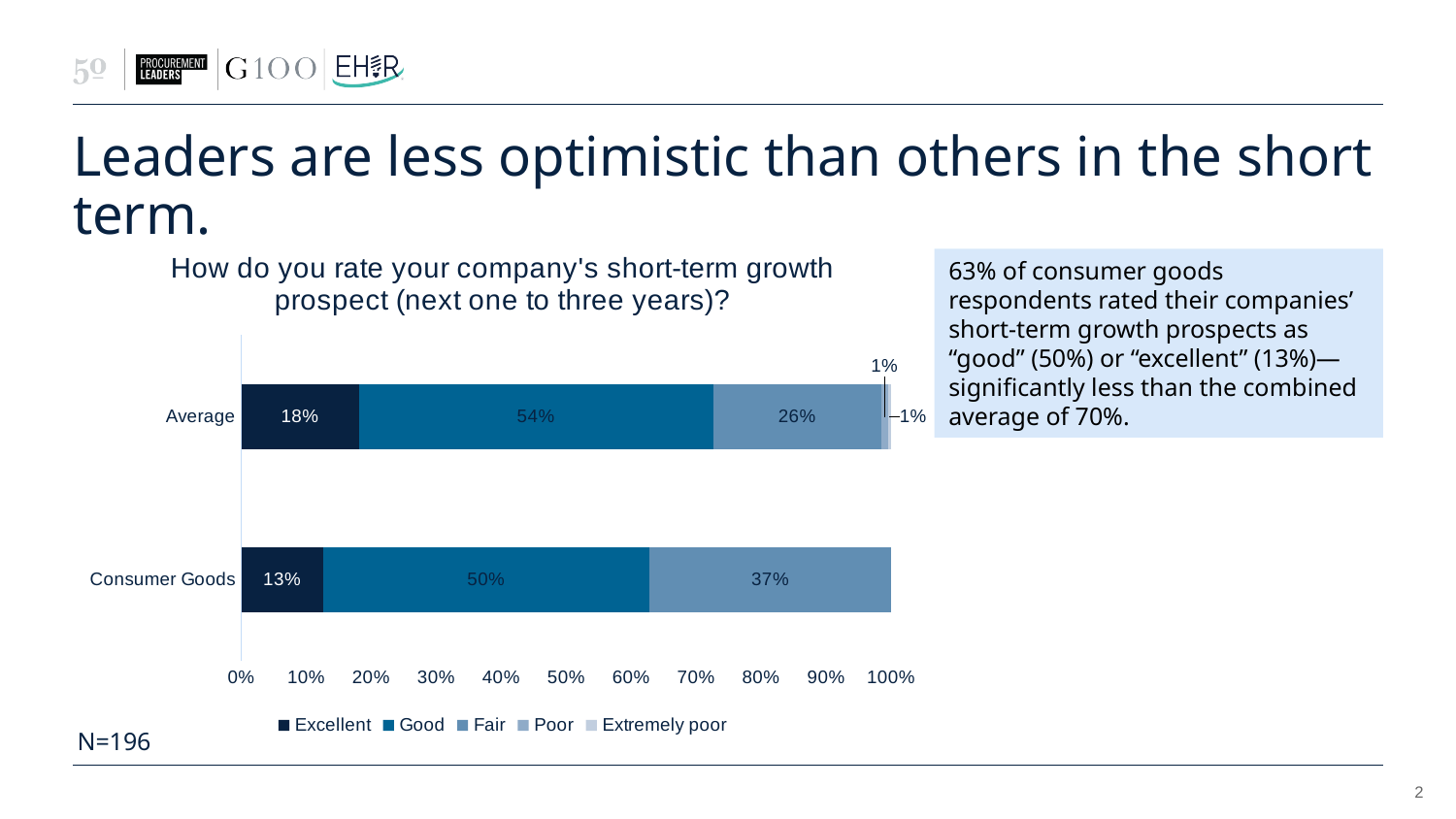
What percentage of Average respondents rated their short-term growth prospect as Excellent? 18% What is the Poor share for Average? 1% How many categories are shown on the chart? 2 What percentage of Consumer Goods respondents rated their short-term growth prospect as Good? 50% What is the difference between the Fair share for Consumer Goods and the Fair share for Average? 11% What is the Good share for Average? 54% How many series does the legend list? 5 What is the difference between the Good share for Average and the Good share for Consumer Goods? 4% What kind of chart is shown on the slide? Stacked bar chart What is the title of the chart? How do you rate your company's short-term growth prospect (next one to three years)? What is the Fair share for Consumer Goods? 37% Which category has the larger Excellent share, Average or Consumer Goods? Average